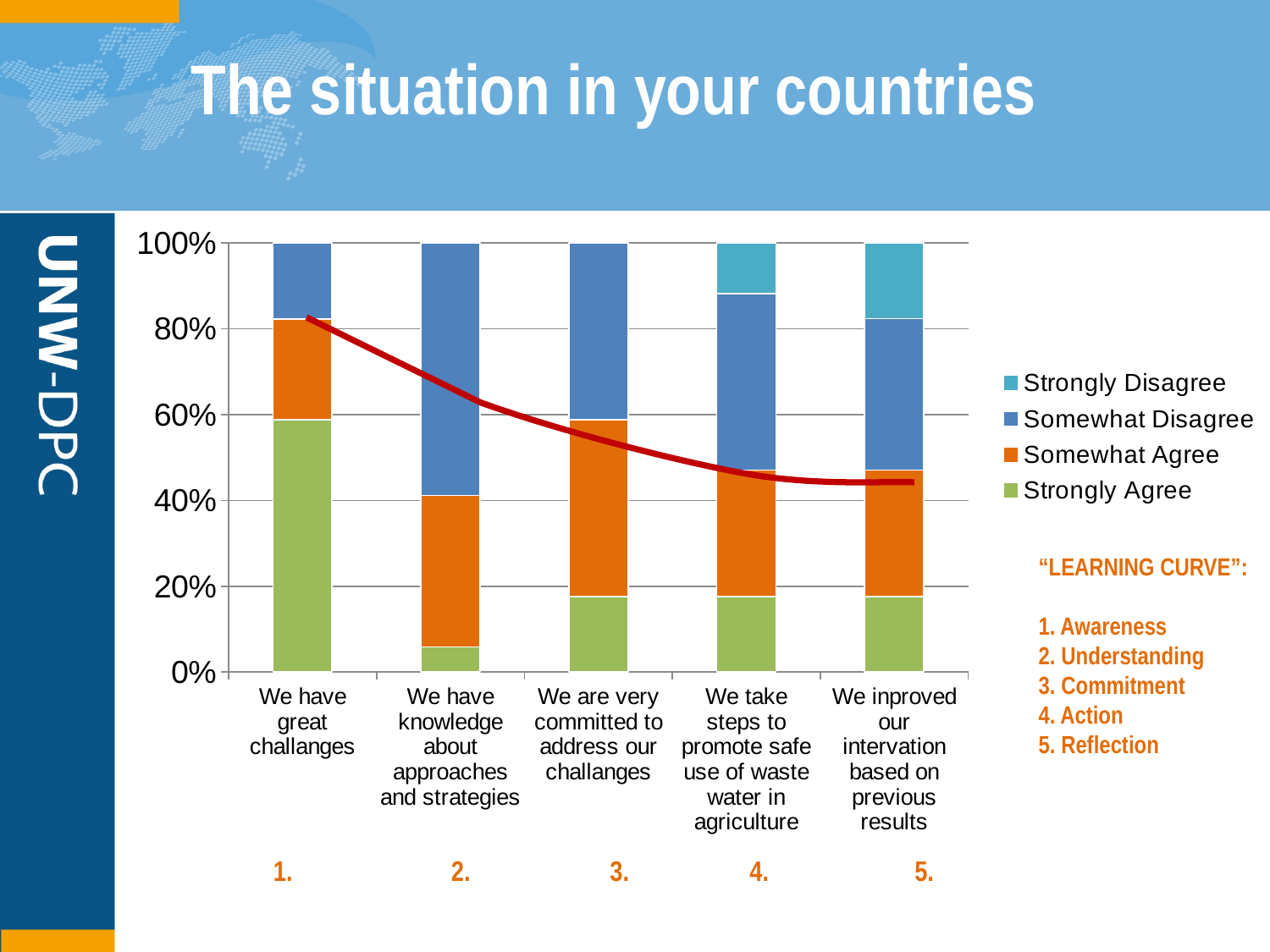
Which statement has the largest Strongly Agree share? We have great challanges What does the text beside the chart call the red curve? "LEARNING CURVE" How many statements (categories) are plotted along the x axis? 5 How many series does the legend list? 4 Is the Strongly Agree share for "We have knowledge about approaches and strategies" greater or less than 20%? less How many statements show a Strongly Disagree segment? 2 Does the red curve rise or fall from left to right across the chart? Falls Which colour represents Strongly Agree in the legend? Green Which has the larger Somewhat Disagree share: "We have great challanges" or "We have knowledge about approaches and strategies"? We have knowledge about approaches and strategies Which statement has the smallest Strongly Agree share? We have knowledge about approaches and strategies Is the Strongly Agree share for "We have great challanges" greater or less than 40%? greater What kind of chart is shown on the slide? Stacked bar chart